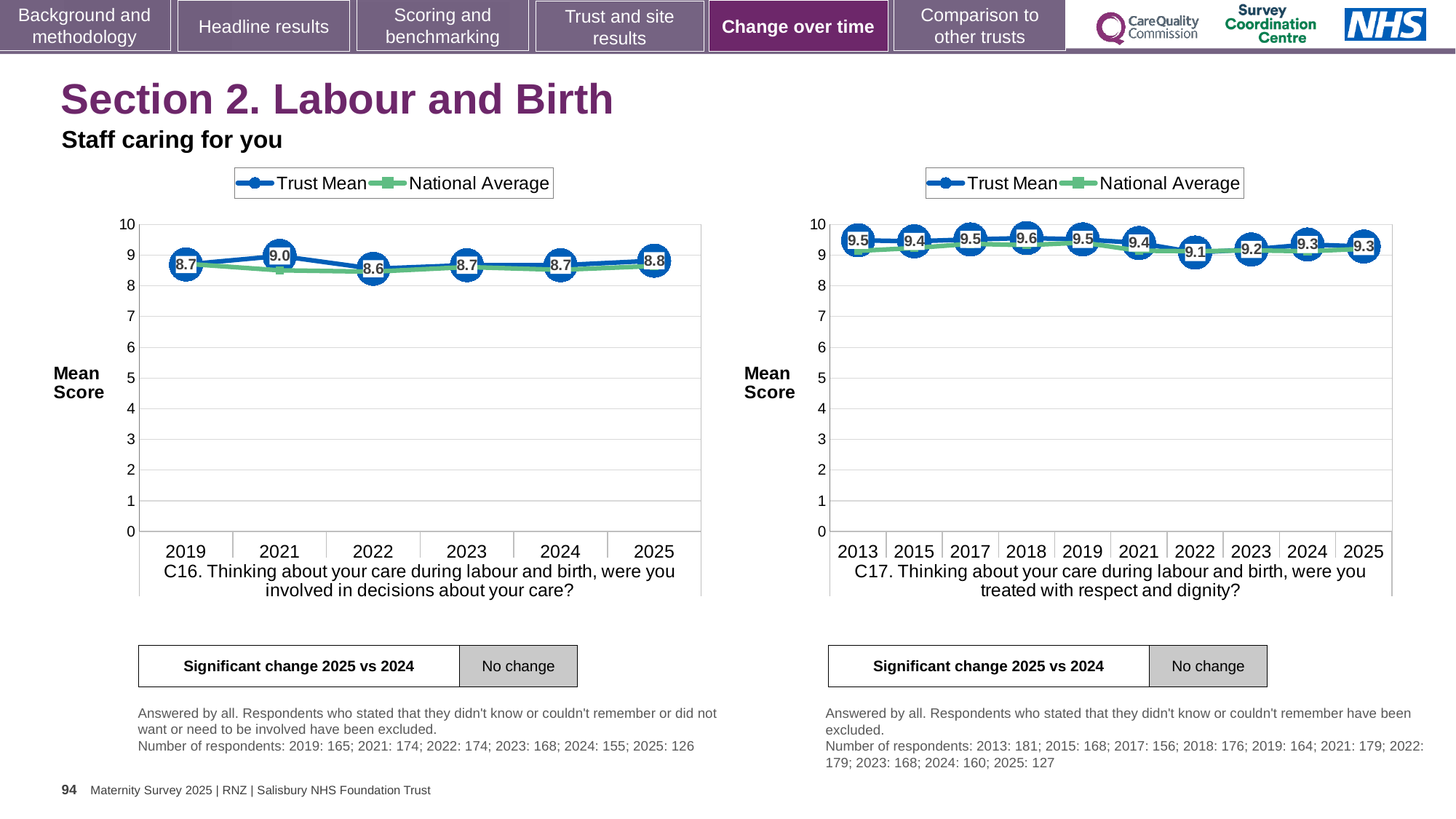
In the C16 chart, which year has the lowest Trust Mean score? 2022 In the C16 chart, which year has the highest Trust Mean score? 2021 How many series does the legend of the C17 chart list? 2 In the C17 chart, is the Trust Mean score for 2018 larger or smaller than the score for 2022? larger In the C17 chart, what is the Trust Mean score for 2022? 9.1 How many years are plotted in the C17 chart? 10 In the C17 chart, which year has the lowest Trust Mean score? 2022 In the C16 chart, what is the Trust Mean score for 2021? 9.0 In the C16 chart, what is the Trust Mean score for 2025? 8.8 In the C17 chart, what is the Trust Mean score for 2018? 9.6 In the C16 chart, what is the difference between the Trust Mean scores for 2021 and 2022? 0.4 How many years are plotted in the C16 chart? 6